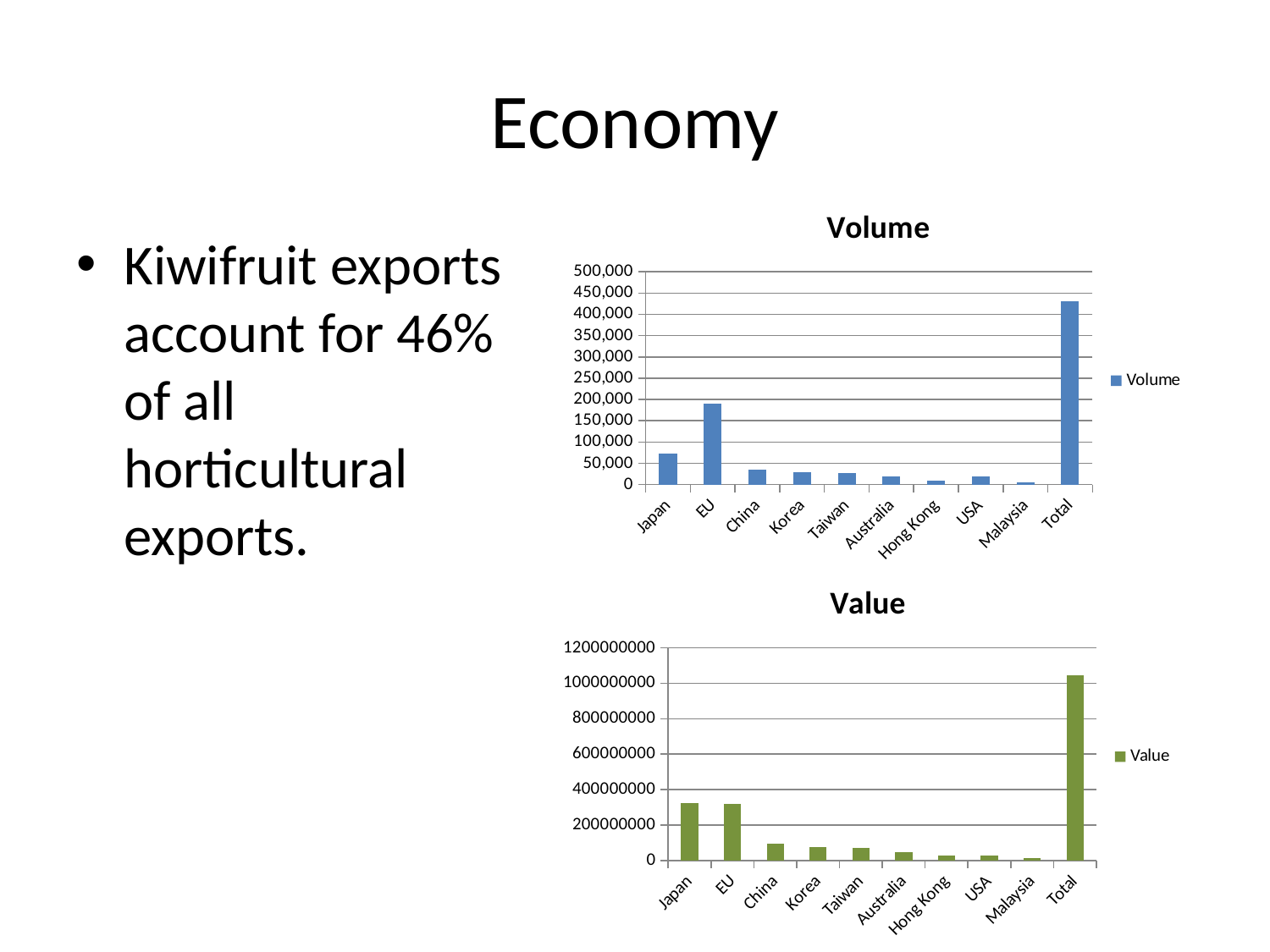
In the Volume chart, which is larger, the value for Japan or the value for China? Japan What kind of chart is the Volume chart? bar chart What is the legend entry shown on the Value chart? Value In the Volume chart, which individual market (excluding Total) has the highest volume? EU In the Volume chart, is the value for EU greater or less than 150,000? greater In the Value chart, is the value for China greater or less than 200000000? less In the Volume chart, which category has the highest bar? Total How many series does the legend of the Volume chart list? 1 How many categories are shown on the x axis of the Value chart? 10 In the Value chart, is the value for Total greater or less than 1000000000? greater In the Value chart, which category has the lowest bar? Malaysia